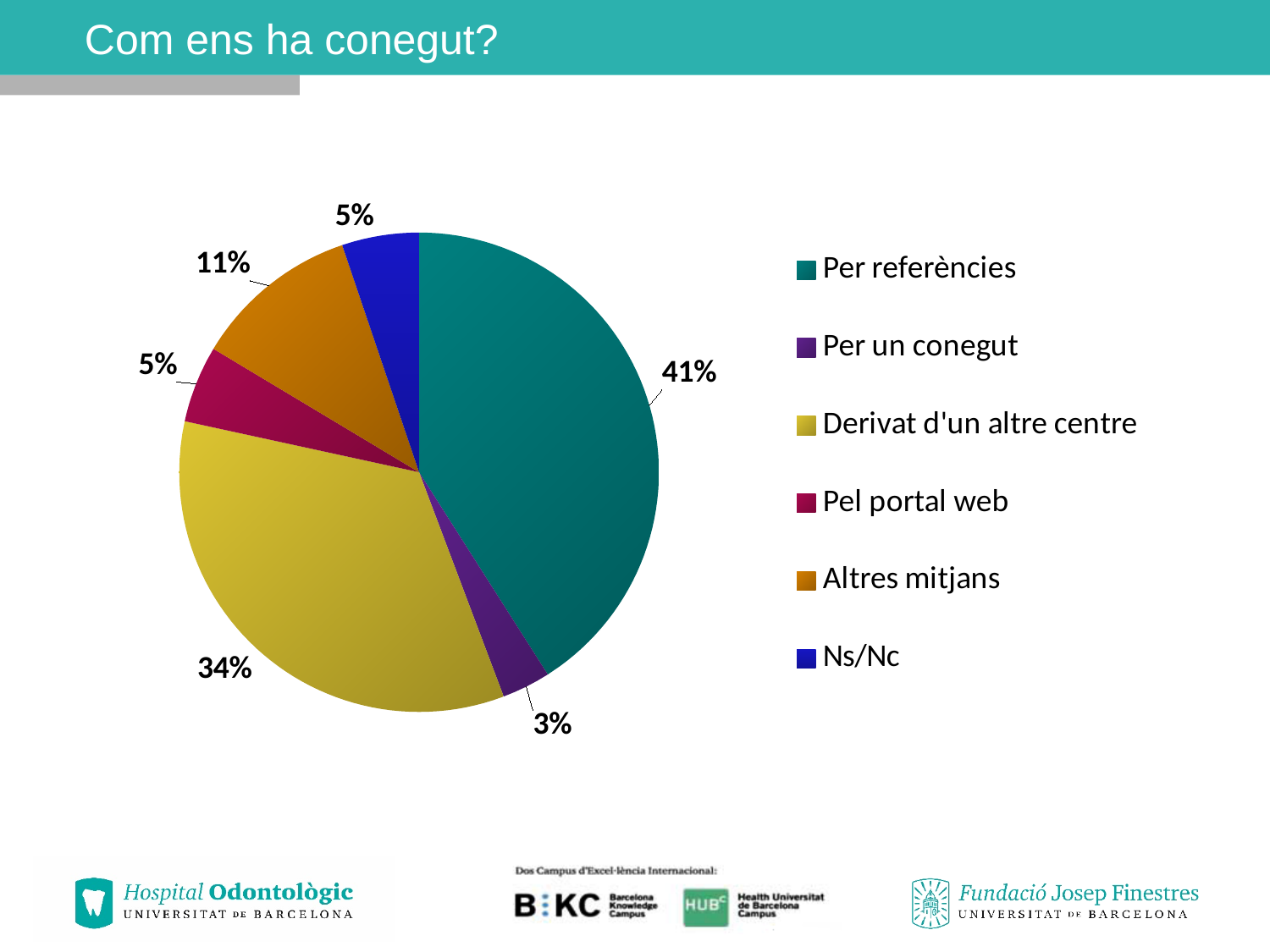
What share of the pie is 'Per un conegut'? 3% Which is larger, 'Altres mitjans' or 'Pel portal web'? Altres mitjans What is the title of the slide containing the pie chart? Com ens ha conegut? What share of the pie is 'Derivat d'un altre centre'? 34% How many categories does the legend list? 6 Which category has the largest slice of the pie? Per referències What kind of chart is shown on the slide? pie chart What share of the pie is 'Altres mitjans'? 11% What is the difference in percentage points between 'Per referències' and 'Derivat d'un altre centre'? 7 What share of the pie is 'Ns/Nc'? 5% What share of the pie is 'Per referències'? 41% Which category has the smallest slice of the pie? Per un conegut